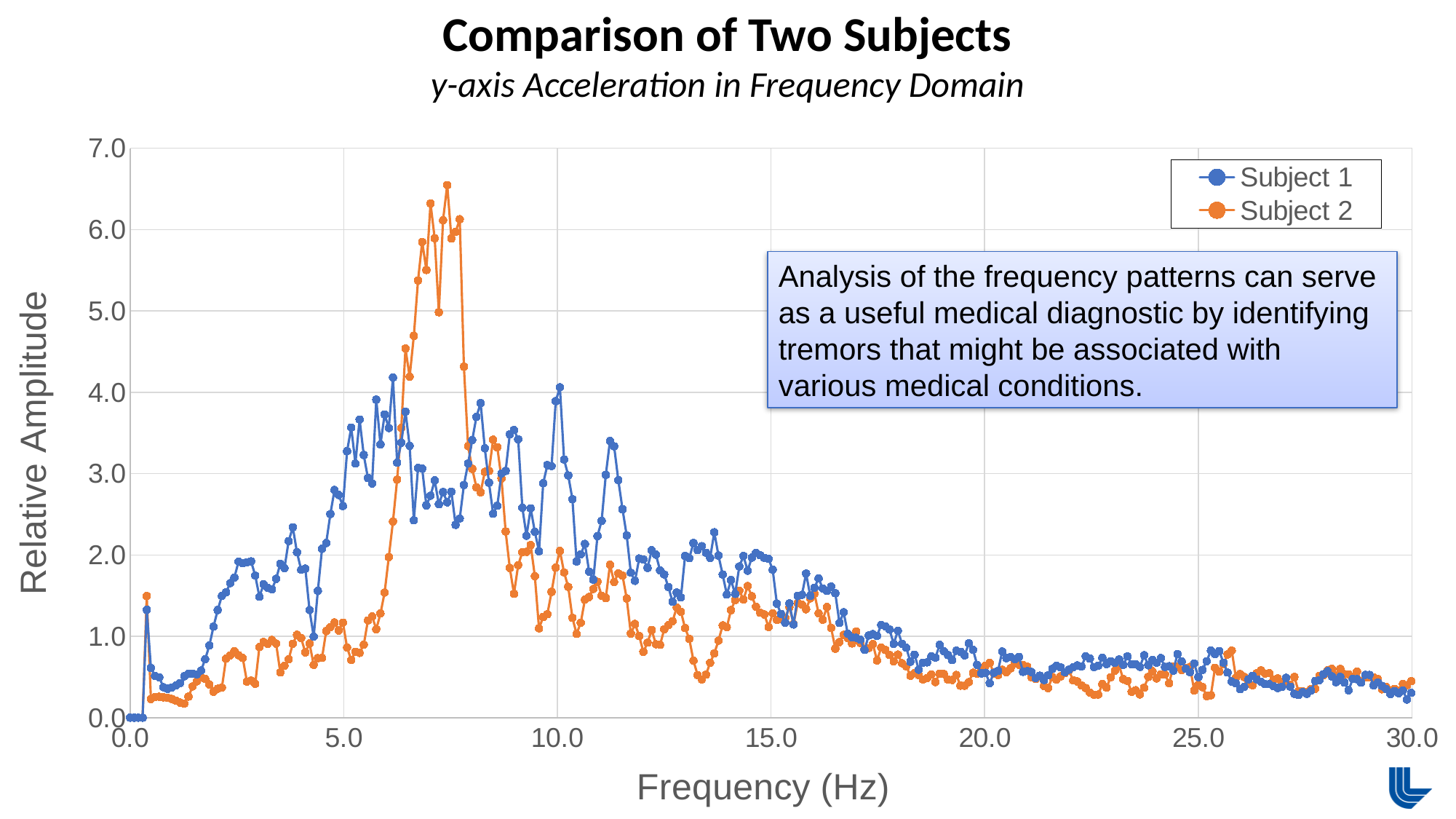
What is the label of the x axis? Frequency (Hz) What is the title of the chart? Comparison of Two Subjects Around 10.0 Hz, which series has the higher relative amplitude, Subject 1 or Subject 2? Subject 1 Which series has the larger peak amplitude, Subject 1 or Subject 2? Subject 2 How many series does the legend list? 2 What kind of chart is shown on the slide? line chart Do the relative amplitudes of both subjects generally rise or fall between 10.0 Hz and 30.0 Hz? fall Is the peak value for Subject 2 greater or less than 6.0? greater Is the value for Subject 1 at 30.0 Hz greater or less than 1.0? less What is the highest value shown on the y axis? 7.0 Which series reaches the highest relative amplitude on the chart? Subject 2 Is the peak value for Subject 1 greater or less than 5.0? less